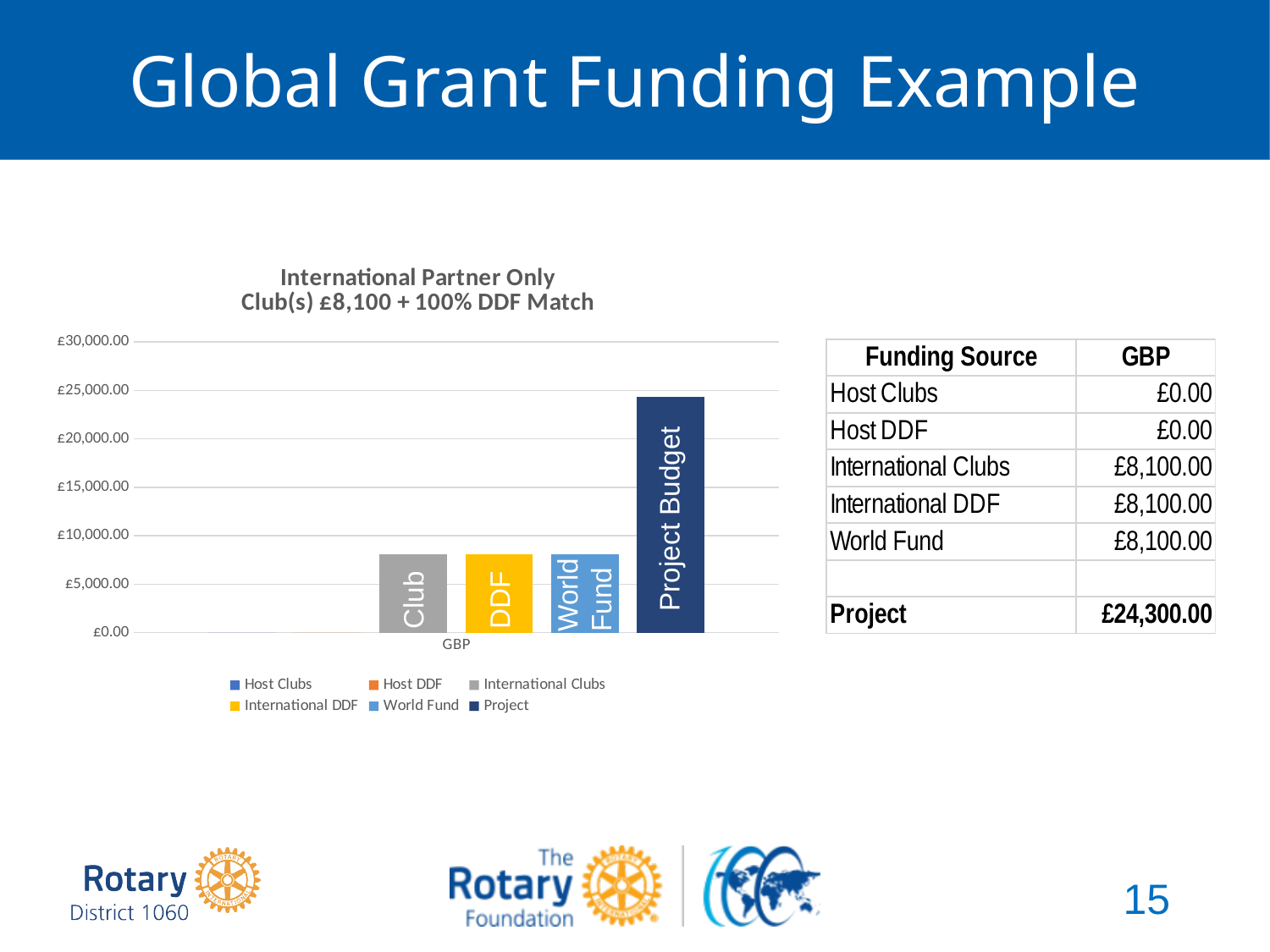
Is the value of the World Fund bar greater or less than £10,000.00? less Is the value of the DDF bar greater or less than £5,000.00? greater Which bar in the chart is the tallest? Project Budget How many bars are visible in the chart? 4 What kind of chart is shown on the slide? bar chart Which is larger, the Project Budget bar or the World Fund bar? Project Budget How many series does the chart legend list? 6 According to the table beside the chart, what is the Project total in GBP? £24,300.00 What is the title of the chart? International Partner Only Club(s) £8,100 + 100% DDF Match Is the value of the Club bar greater or less than £10,000.00? less What is the category label shown on the x axis of the chart? GBP